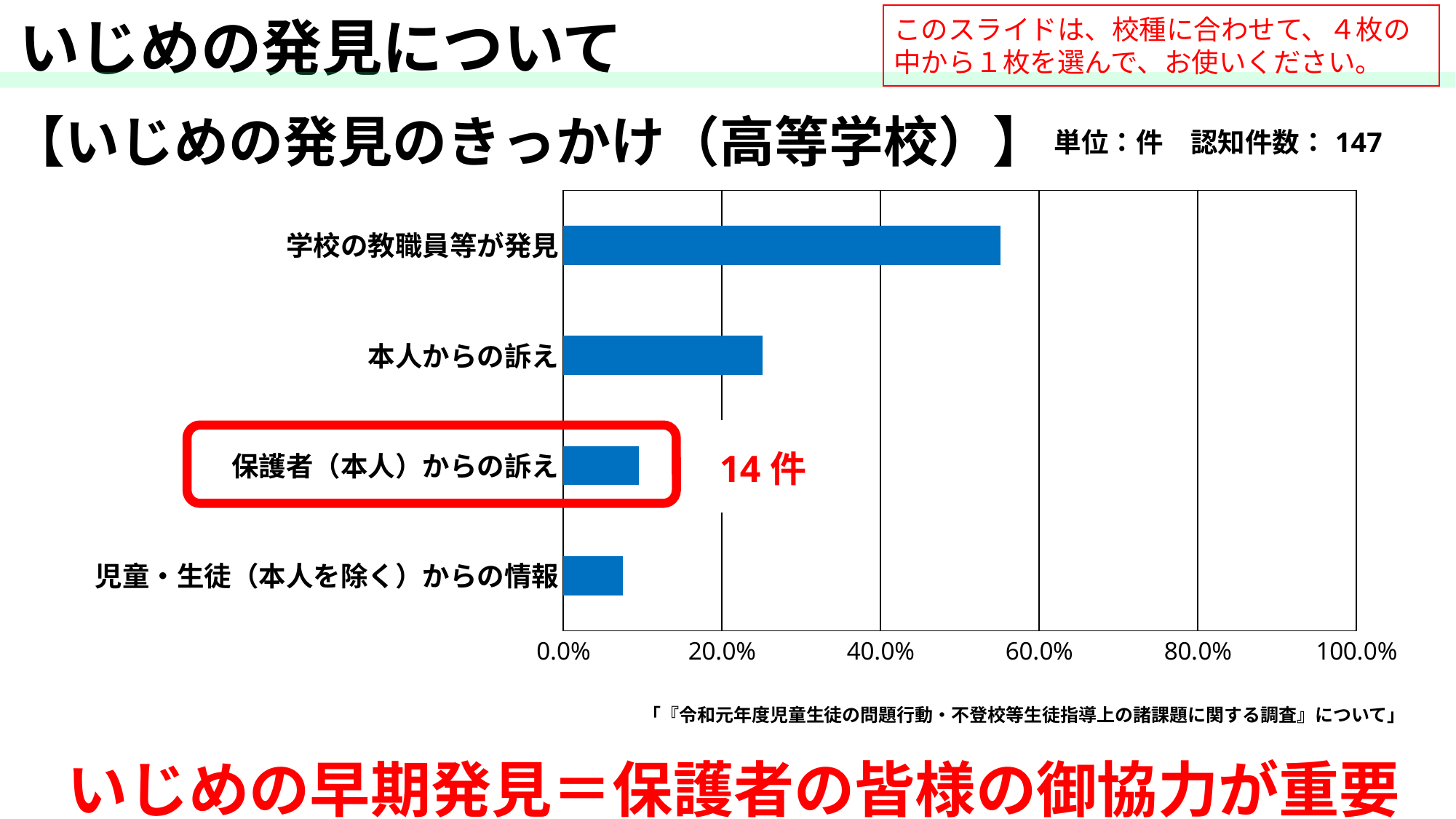
How many categories are plotted in the chart? 4 Is the value for 学校の教職員等が発見 greater or less than 40.0%? greater Is the value for 児童・生徒（本人を除く）からの情報 greater or less than 20.0%? less Is the value for 保護者（本人）からの訴え greater or less than 20.0%? less Which category has the highest value in the chart? 学校の教職員等が発見 What is the 認知件数 (number of recognized cases) stated above the chart? 147 Which is larger, the value for 学校の教職員等が発見 or the value for 本人からの訴え? 学校の教職員等が発見 How many cases (件) are annotated next to the bar for 保護者（本人）からの訴え? 14 件 What kind of chart is shown on the slide? bar chart What is the title of the chart? いじめの発見のきっかけ（高等学校）